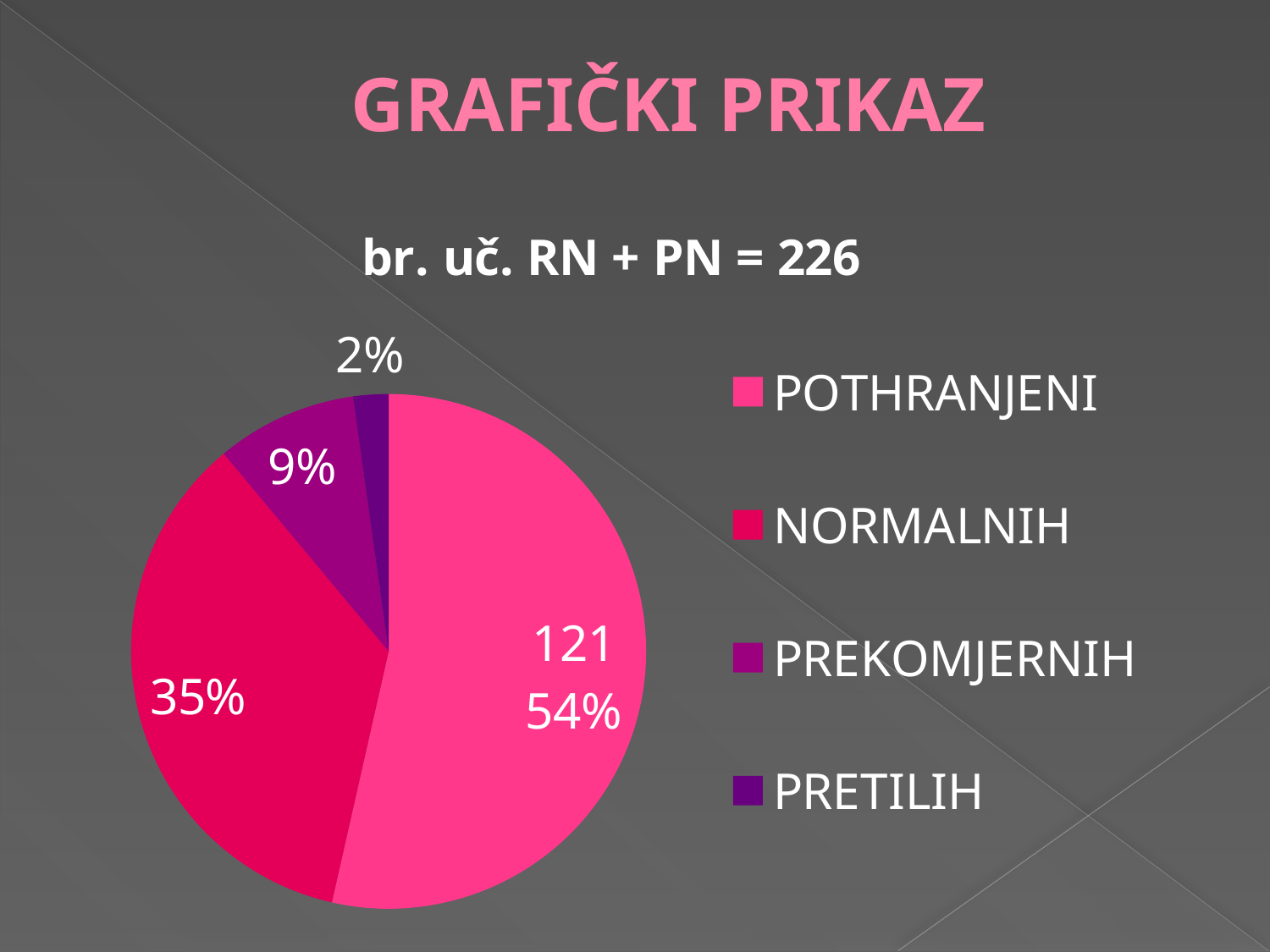
How many slices does the pie chart have? 4 By how many percentage points does the POTHRANJENI share exceed the NORMALNIH share? 19 Which category has the smallest slice? PRETILIH What share of the pie does PRETILIH take? 2% What kind of chart is shown on the slide? pie chart What share of the pie does NORMALNIH take? 35% What value is printed on the POTHRANJENI slice besides its percentage? 121 Which category has the largest slice? POTHRANJENI How many entries does the legend list? 4 What share of the pie does PREKOMJERNIH take? 9% What is the title of the chart? br. uč. RN + PN = 226